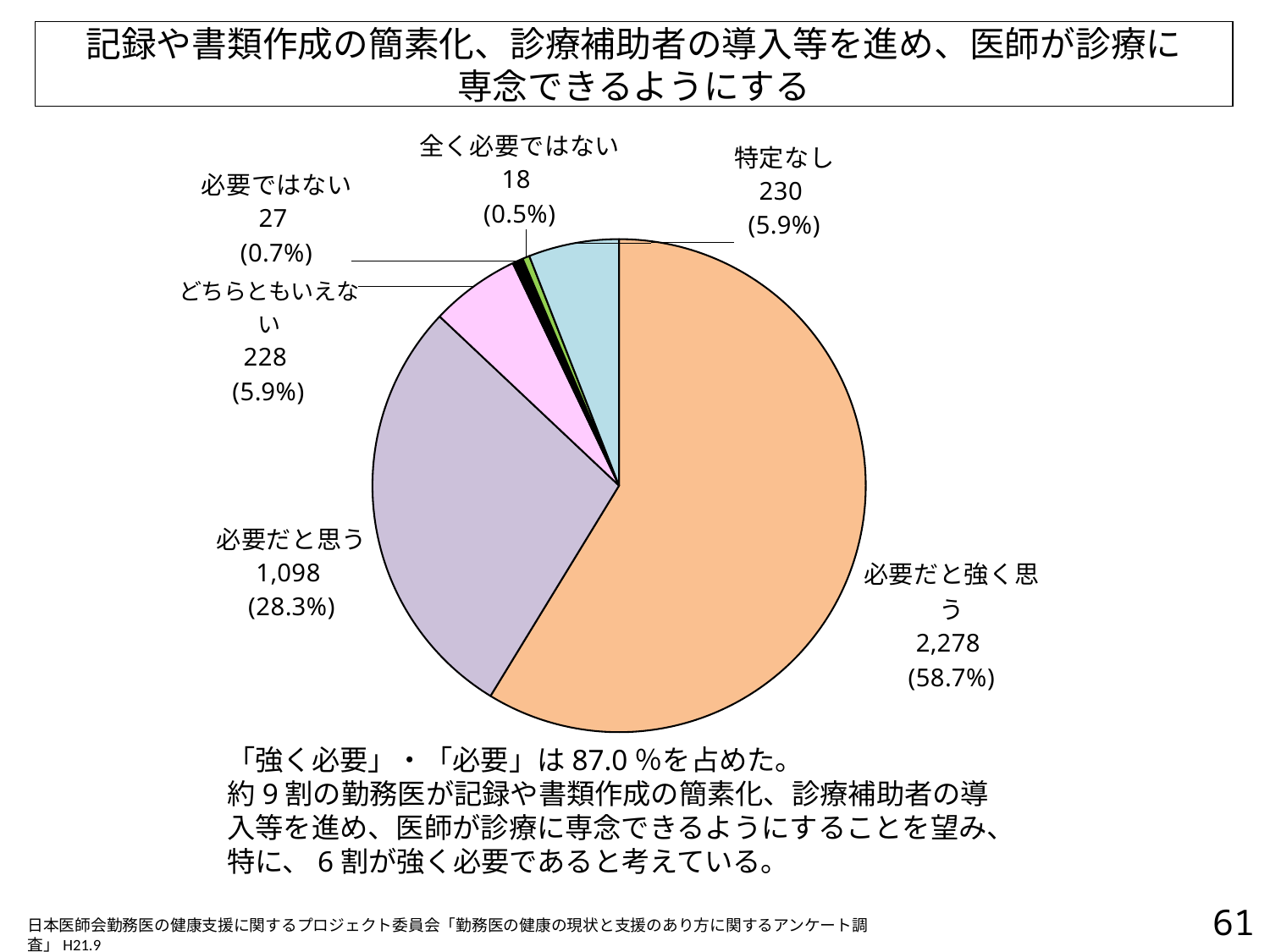
What is the value for どちらともいえない? 228 What is the value for 特定なし? 230 Which is larger, the value for 必要ではない or the value for 全く必要ではない? 必要ではない What is the value for 必要だと思う? 1,098 How many categories (slices) does the pie chart have? 6 What share of the pie does 必要だと思う represent? 28.3% What share of the pie does 必要ではない represent? 0.7% What is the difference between the values for 必要だと強く思う and 必要だと思う? 1,180 Which category has the smallest slice? 全く必要ではない What kind of chart is shown on the slide? pie chart What is the value for 必要だと強く思う? 2,278 Which category has the largest slice? 必要だと強く思う